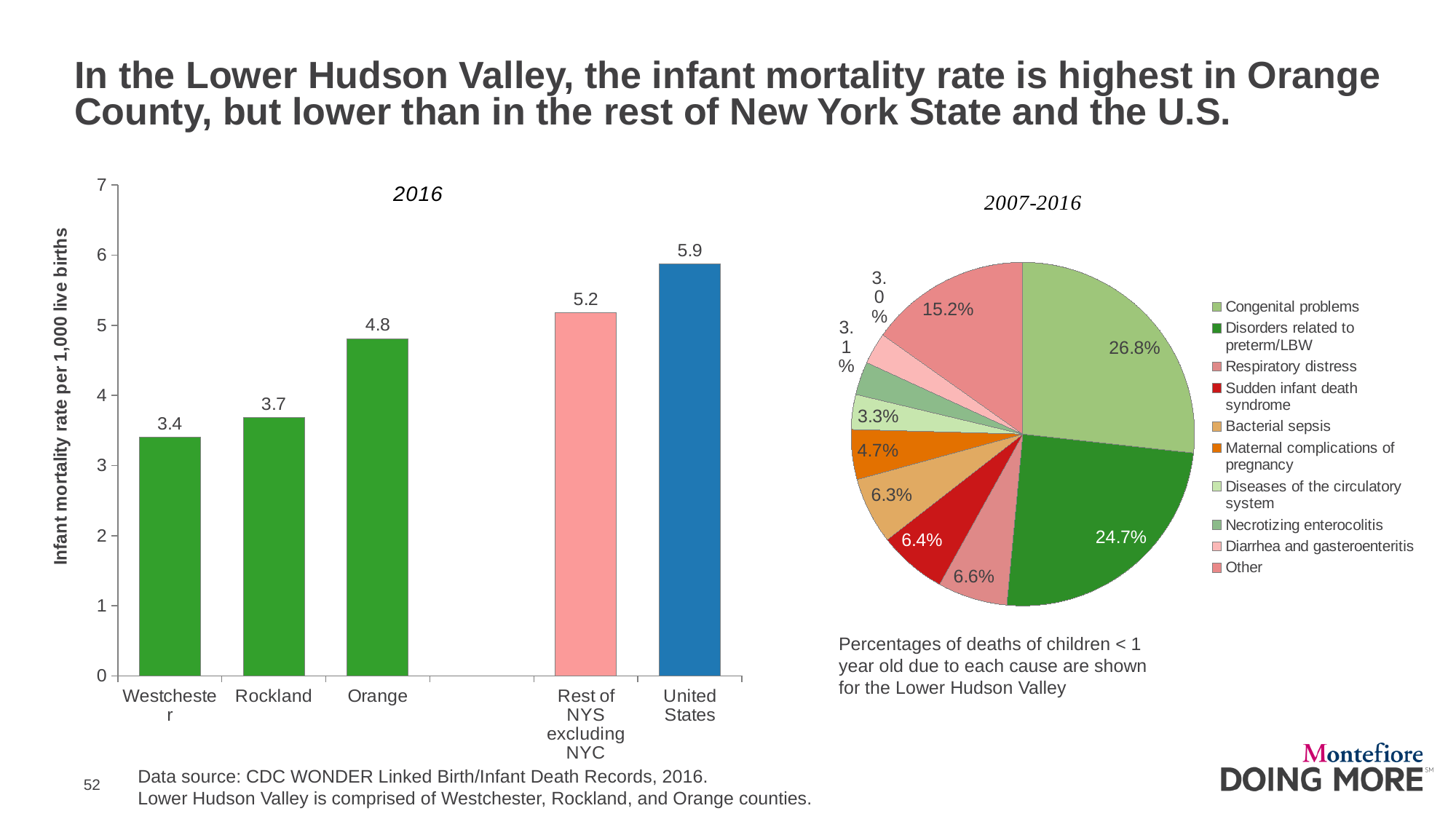
In the 2016 bar chart, which category has the highest infant mortality rate? United States How many bars are shown in the 2016 bar chart? 5 In the 2016 bar chart, what is the infant mortality rate for Orange? 4.8 In the 2007-2016 pie chart, what share of deaths is due to congenital problems? 26.8% In the 2007-2016 pie chart, what percentage is shown for disorders related to preterm/LBW? 24.7% What is the y-axis label of the 2016 bar chart? Infant mortality rate per 1,000 live births In the 2016 bar chart, which is larger, the rate for Rockland or the rate for Orange? Orange What type of chart is the 2016 chart on the left? Bar chart How many causes does the legend of the 2007-2016 pie chart list? 10 In the 2016 bar chart, what is the infant mortality rate for the United States? 5.9 In the 2016 bar chart, which category has the lowest infant mortality rate? Westchester In the 2016 bar chart, what is the difference between the rate for Rest of NYS excluding NYC and the rate for Rockland? 1.5